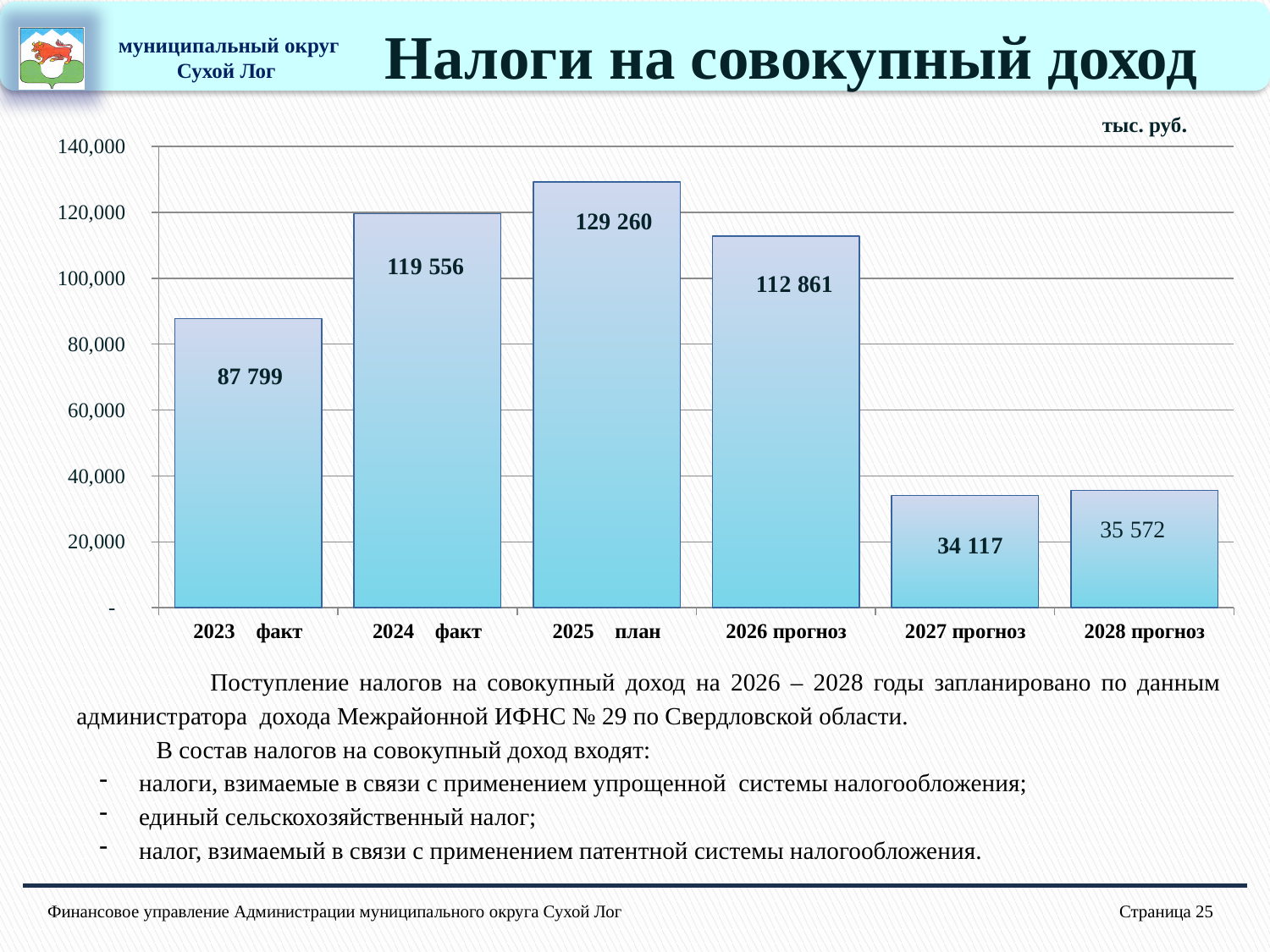
What is the value for 2027 прогноз? 34 117 What is the difference between the values for 2024 факт and 2023 факт? 31 757 Which is larger, the value for 2026 прогноз or the value for 2024 факт? 2024 факт What is the value for 2028 прогноз? 35 572 Is the value for 2026 прогноз greater or less than 100,000? greater What is the value for 2025 план? 129 260 What is the difference between the values for 2025 план and 2024 факт? 9 704 Which category has the lowest value? 2027 прогноз What kind of chart is shown on the slide? bar chart What is the value for 2023 факт? 87 799 Which category has the highest value? 2025 план How many categories are shown on the x axis? 6